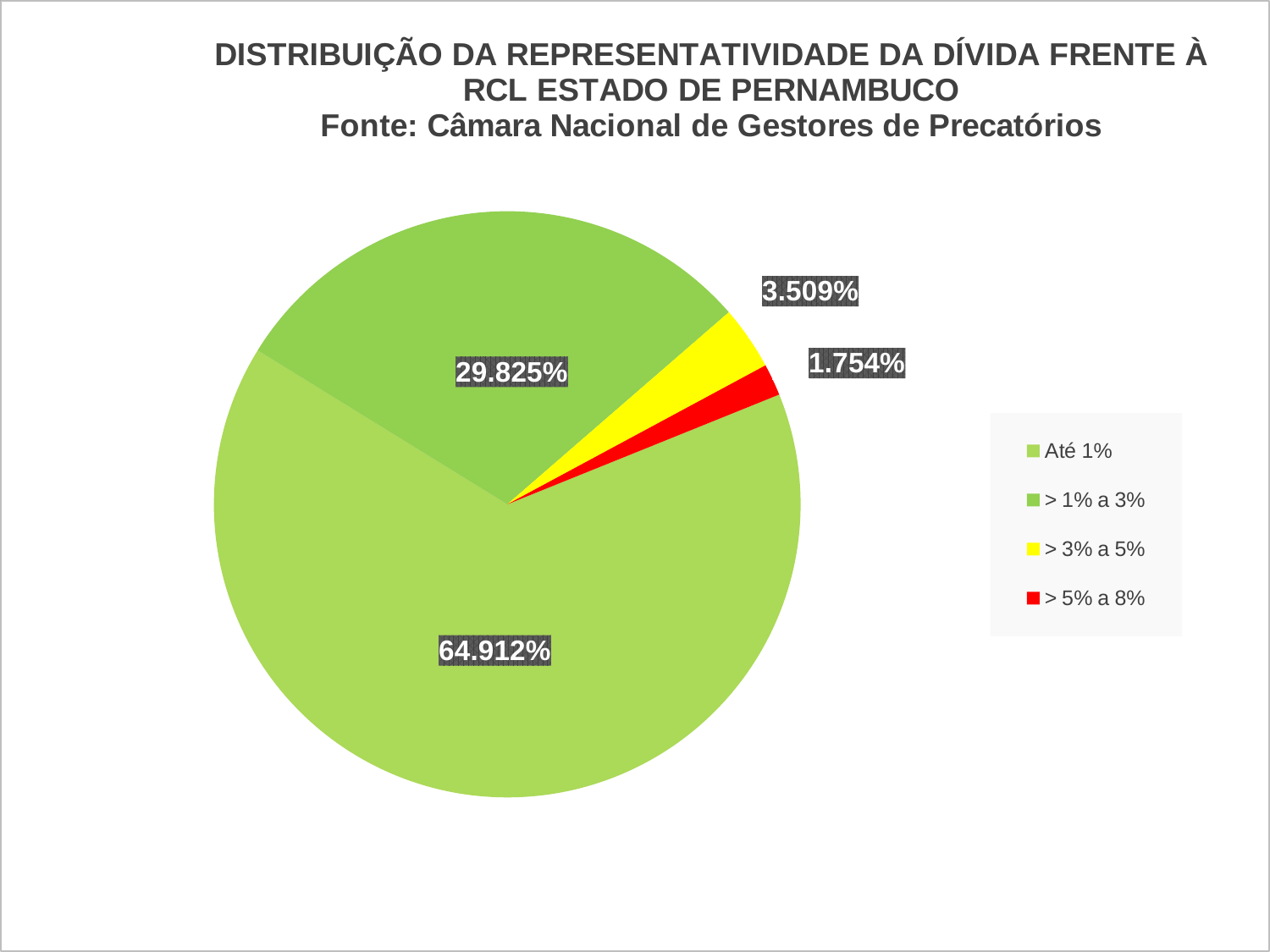
Which category has the smallest slice of the pie? > 5% a 8% What is the difference between the '> 3% a 5%' slice and the '> 5% a 8%' slice? 1.755% Which category has the largest slice of the pie? Até 1% What is the value shown for the '> 1% a 3%' slice? 29.825% What kind of chart is shown on the slide? Pie chart How many categories does the legend list? 4 What is the difference between the 'Até 1%' slice and the '> 1% a 3%' slice? 35.087% Which is larger, the '> 3% a 5%' slice or the '> 5% a 8%' slice? > 3% a 5% What colour is the '> 5% a 8%' slice in the pie chart? Red What is the value shown for the '> 5% a 8%' slice? 1.754% What is the value shown for the '> 3% a 5%' slice? 3.509% What share of the pie does the 'Até 1%' slice represent? 64.912%